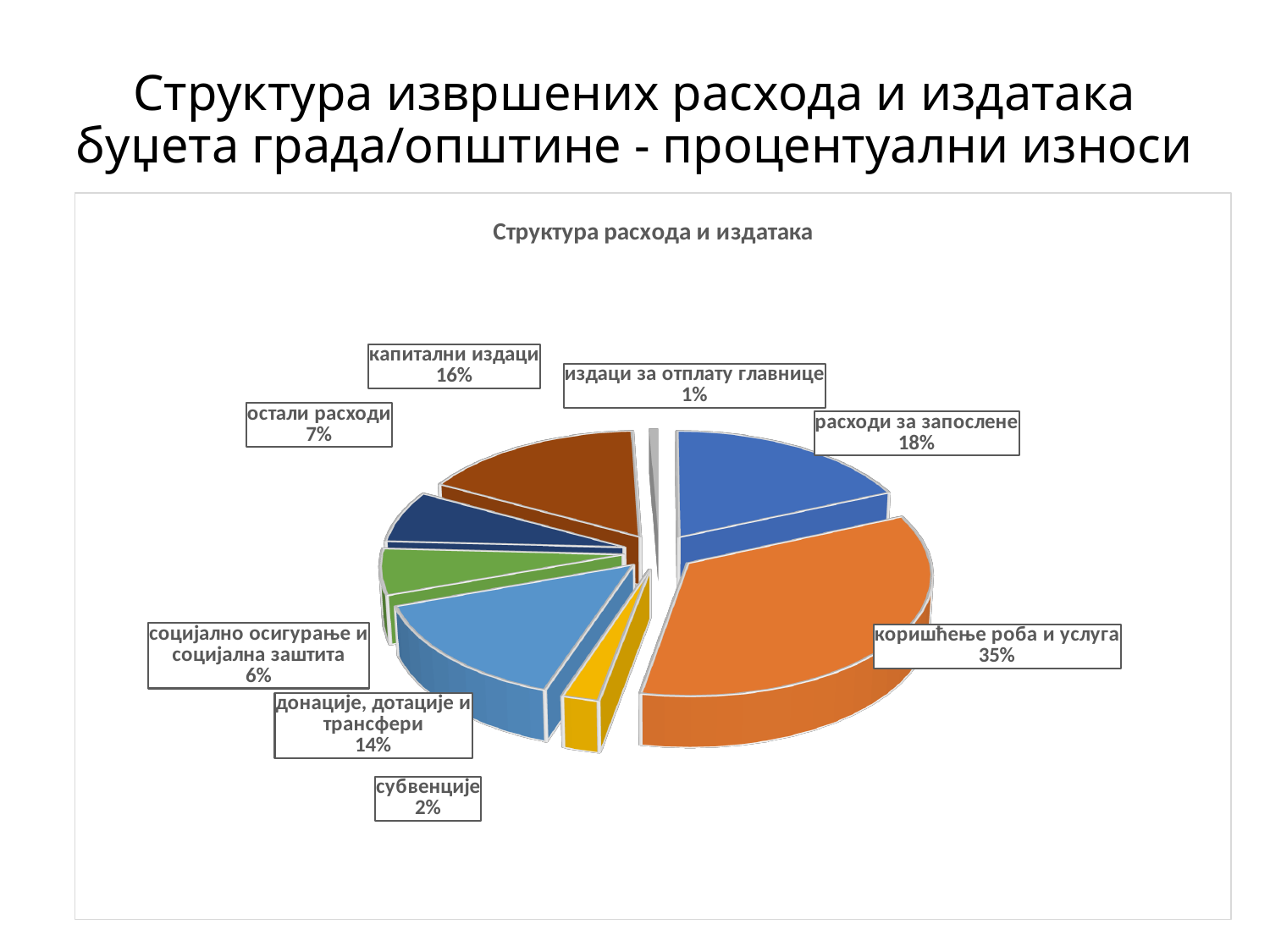
Which category has the largest share? коришћење роба и услуга Which category has the smallest share? издаци за отплату главнице What share does 'издаци за отплату главнице' have? 1% What share does 'донације, дотације и трансфери' have? 14% What is the difference between the shares of 'коришћење роба и услуга' and 'расходи за запослене'? 17% How many categories are shown in the pie chart? 8 What share does 'расходи за запослене' have? 18% What share does 'капитални издаци' have? 16% What type of chart is shown on the slide? Pie chart Which is larger, 'остали расходи' or 'социјално осигурање и социјална заштита'? остали расходи What is the chart's title? Структура расхода и издатака What share does 'коришћење роба и услуга' have? 35%